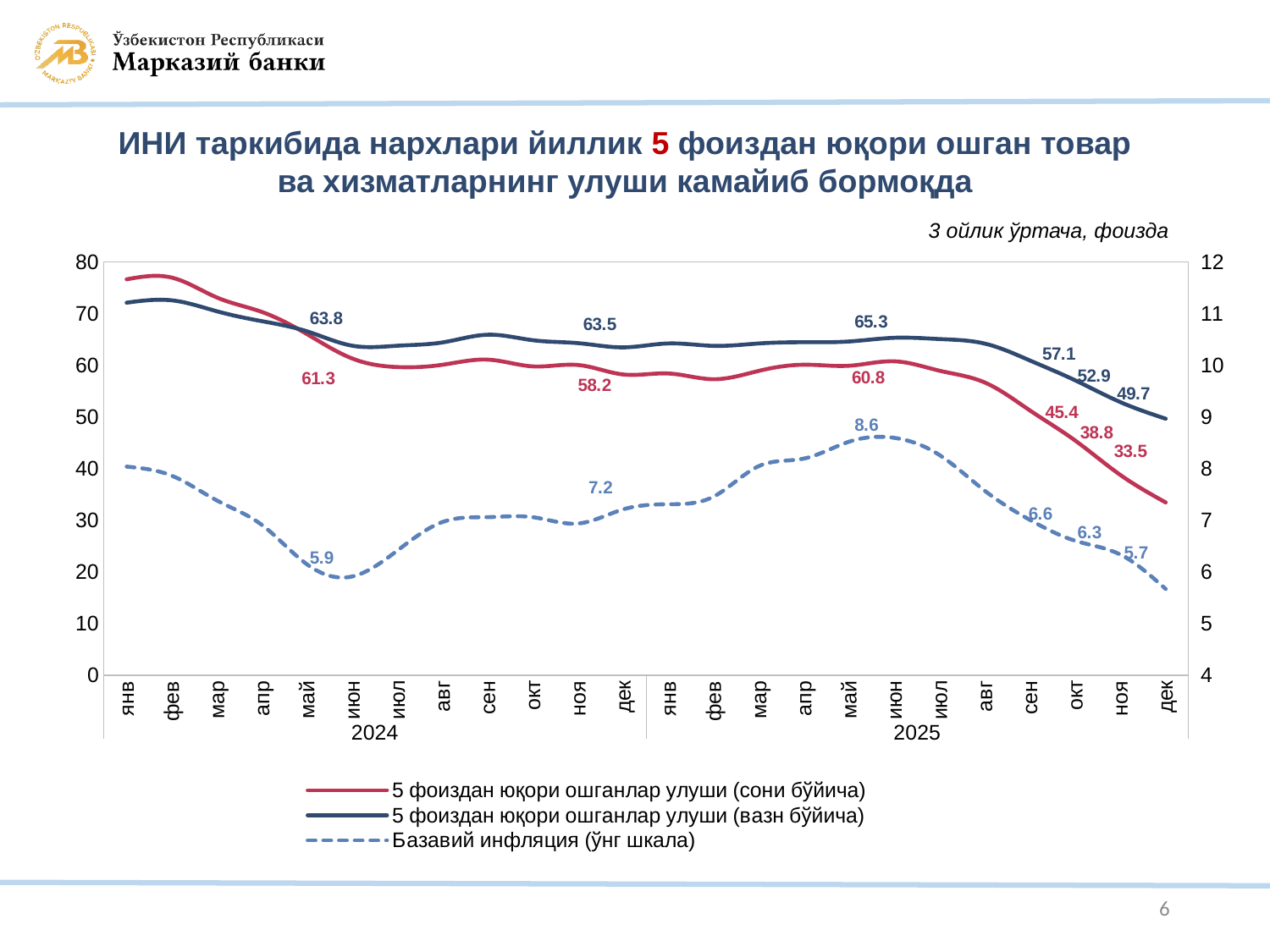
In November 2024, which is higher: the share by weight (вазн бўйича) or the share by count (сони бўйича)? share by weight (вазн бўйича) How many series does the legend list? 3 Does the '5 фоиздан юқори ошганлар улуши (сони бўйича)' line rise or fall over the second half of 2025? fall Which series in the legend is plotted on the right-hand axis? Базавий инфляция (ўнг шкала) What is the last labelled value of the '5 фоиздан юқори ошганлар улуши (сони бўйича)' line? 33.5 What kind of chart is shown on the slide? line chart What is the highest labelled value of the 'Базавий инфляция (ўнг шкала)' line? 8.6